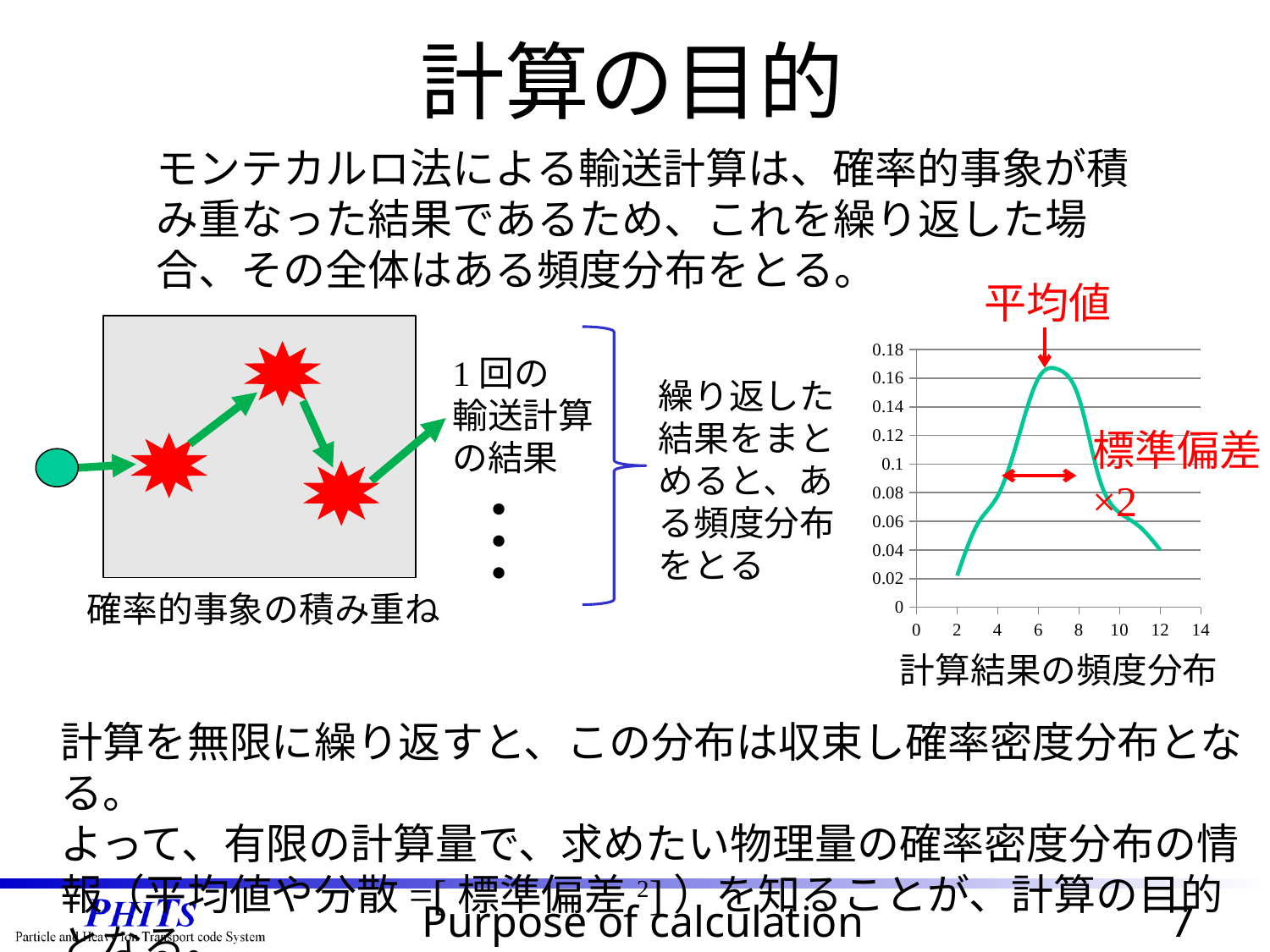
In the chart titled 計算結果の頻度分布, is the peak of the curve greater or less than 0.14? greater In the chart titled 計算結果の頻度分布, does the curve rise or fall between x = 2 and x = 6? rise In the chart titled 計算結果の頻度分布, is the peak of the curve greater or less than 0.18? less In the chart titled 計算結果の頻度分布, is the value of the curve at x = 12 greater or less than 0.08? less In the chart titled 計算結果の頻度分布, what is the highest value shown on the vertical axis? 0.18 What kind of chart is shown on the right side of the slide under the caption 計算結果の頻度分布? line chart In the chart titled 計算結果の頻度分布, what does the red label with the downward arrow pointing at the peak of the curve say? 平均値 In the chart titled 計算結果の頻度分布, which is larger: the value of the curve at x = 6 or at x = 12? x = 6 In the chart titled 計算結果の頻度分布, what is the highest value shown on the horizontal axis? 14 In the chart titled 計算結果の頻度分布, does the curve rise or fall between x = 8 and x = 12? fall